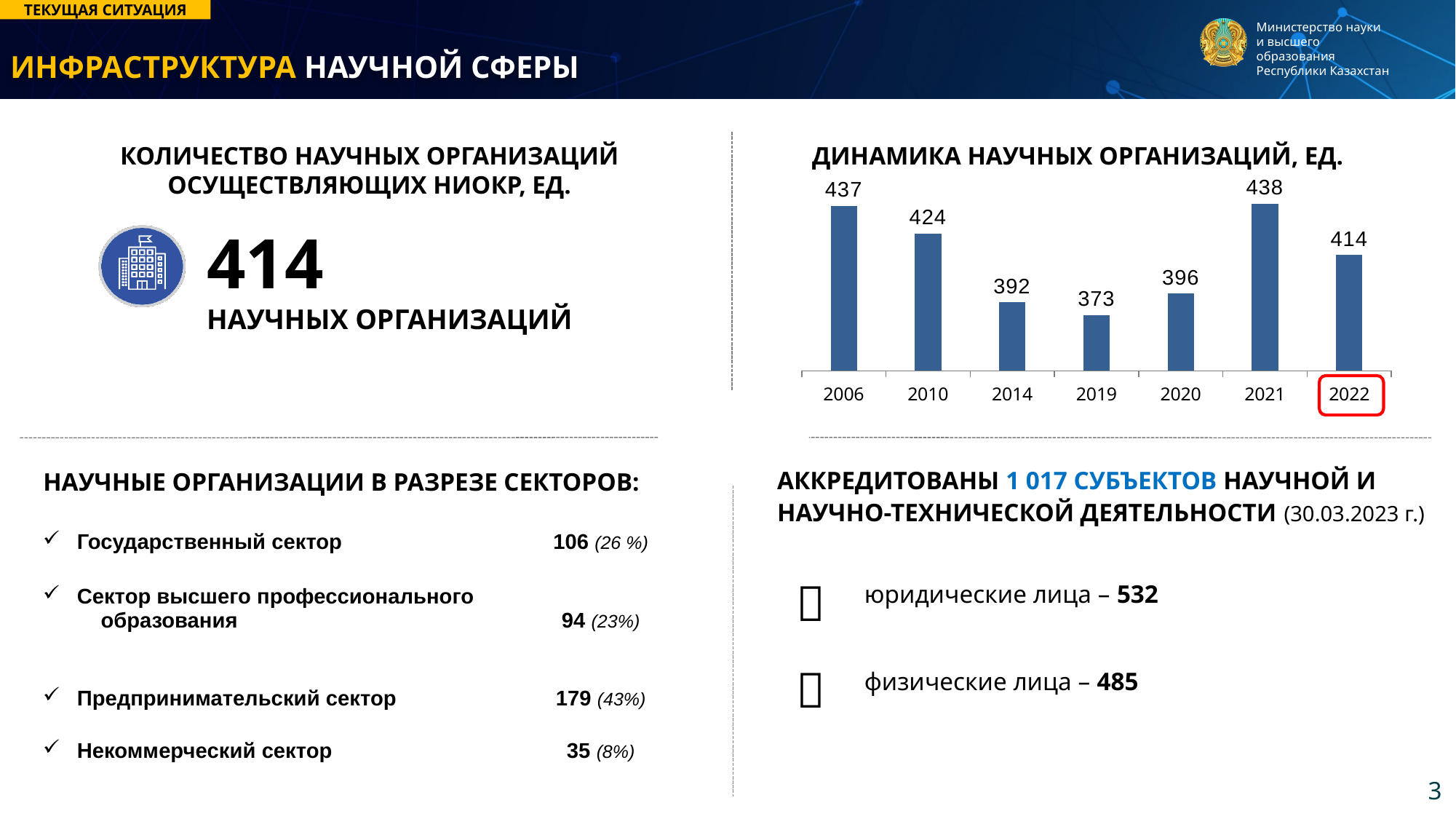
In the chart "ДИНАМИКА НАУЧНЫХ ОРГАНИЗАЦИЙ, ЕД.", what is the value for 2006? 437 In the chart "ДИНАМИКА НАУЧНЫХ ОРГАНИЗАЦИЙ, ЕД.", which year has the highest value? 2021 In the chart "ДИНАМИКА НАУЧНЫХ ОРГАНИЗАЦИЙ, ЕД.", which is larger, the value for 2010 or the value for 2014? 2010 What type of chart is shown under the title "ДИНАМИКА НАУЧНЫХ ОРГАНИЗАЦИЙ, ЕД."? bar chart In the chart "ДИНАМИКА НАУЧНЫХ ОРГАНИЗАЦИЙ, ЕД.", which year has the lowest value? 2019 In the chart "ДИНАМИКА НАУЧНЫХ ОРГАНИЗАЦИЙ, ЕД.", what is the value for 2020? 396 In the chart "ДИНАМИКА НАУЧНЫХ ОРГАНИЗАЦИЙ, ЕД.", what is the difference between the values for 2006 and 2019? 64 How many years (bars) are shown in the chart "ДИНАМИКА НАУЧНЫХ ОРГАНИЗАЦИЙ, ЕД."? 7 In the chart "ДИНАМИКА НАУЧНЫХ ОРГАНИЗАЦИЙ, ЕД.", what is the value for 2019? 373 In the chart "ДИНАМИКА НАУЧНЫХ ОРГАНИЗАЦИЙ, ЕД.", which year label is highlighted with a red box? 2022 In the chart "ДИНАМИКА НАУЧНЫХ ОРГАНИЗАЦИЙ, ЕД.", what is the difference between the values for 2021 and 2022? 24 In the chart "ДИНАМИКА НАУЧНЫХ ОРГАНИЗАЦИЙ, ЕД.", what is the value for 2022? 414